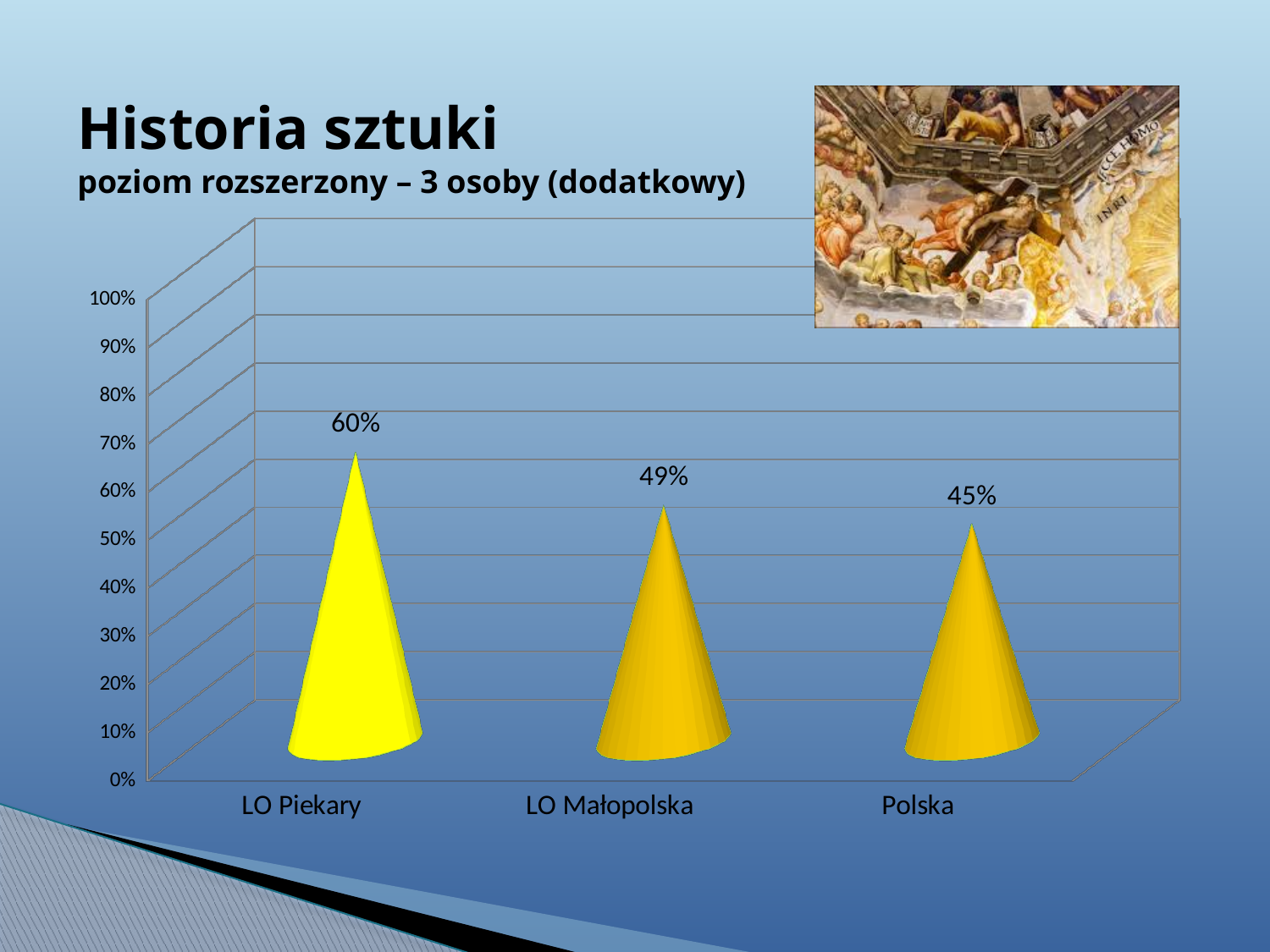
What is the difference between the values for LO Małopolska and Polska? 4% Which category has the lowest value? Polska Is the value for LO Piekary greater or less than 50%? greater What is the value for LO Małopolska? 49% What kind of chart is shown on the slide? bar chart What is the difference between the values for LO Piekary and Polska? 15% What is the value for LO Piekary? 60% Which category has the highest value? LO Piekary What is the value for Polska? 45% How many categories are shown on the x axis? 3 Which is larger, the value for LO Piekary or the value for LO Małopolska? LO Piekary Do the values rise or fall from left to right along the x axis? fall